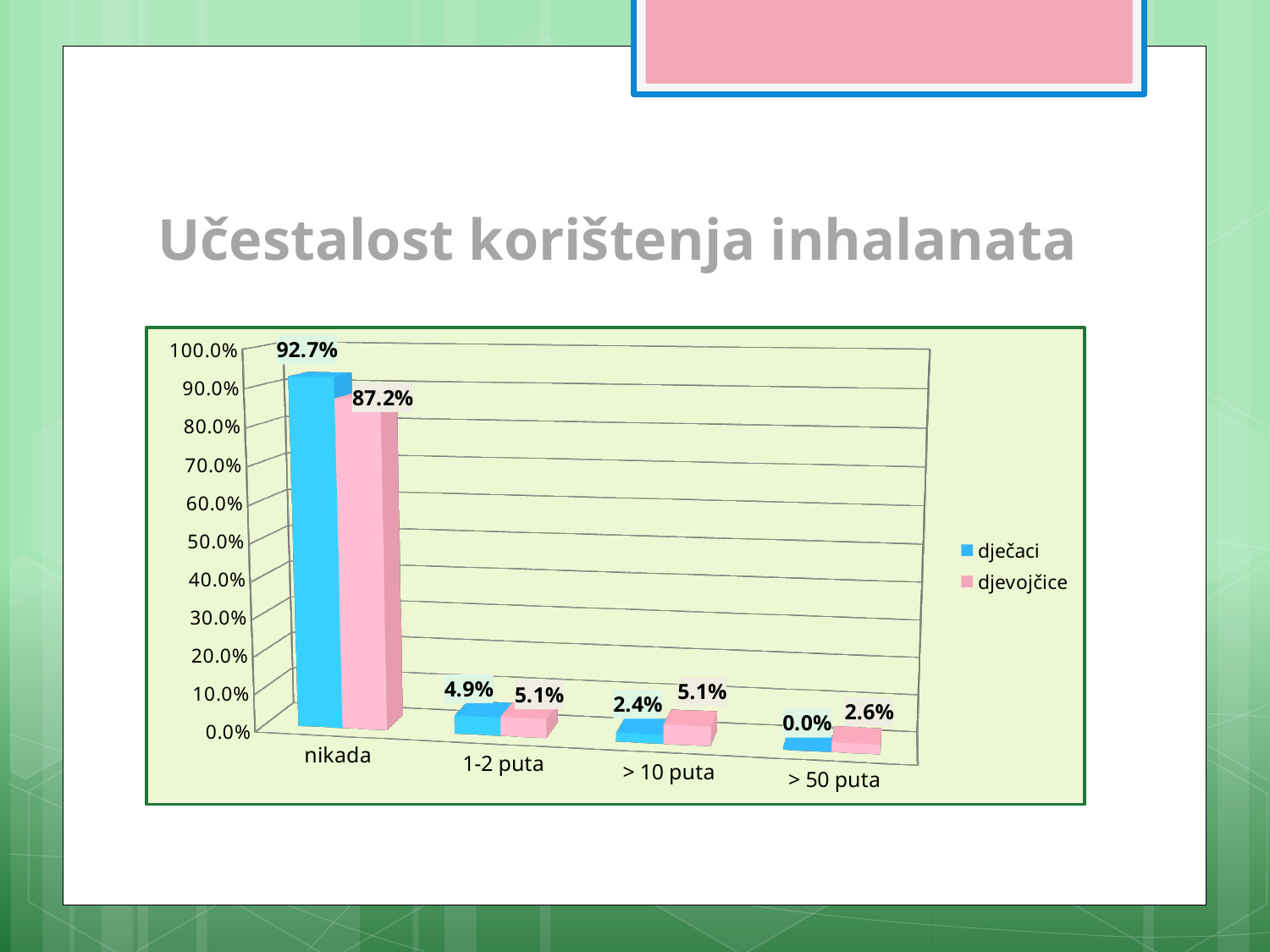
What is the value for djevojčice in the nikada category? 87.2% What is the difference between the dječaci and djevojčice values in the nikada category? 5.5% What is the title of the slide? Učestalost korištenja inhalanata How many categories are shown on the x axis? 4 Which category has the lowest value for dječaci? > 50 puta Which is larger in the 1-2 puta category, dječaci or djevojčice? djevojčice What is the value for dječaci in the nikada category? 92.7% How many series does the legend list? 2 Which category has the highest value for dječaci? nikada What is the value for djevojčice in the > 50 puta category? 2.6% What is the value for dječaci in the > 10 puta category? 2.4% What kind of chart is shown on the slide? bar chart